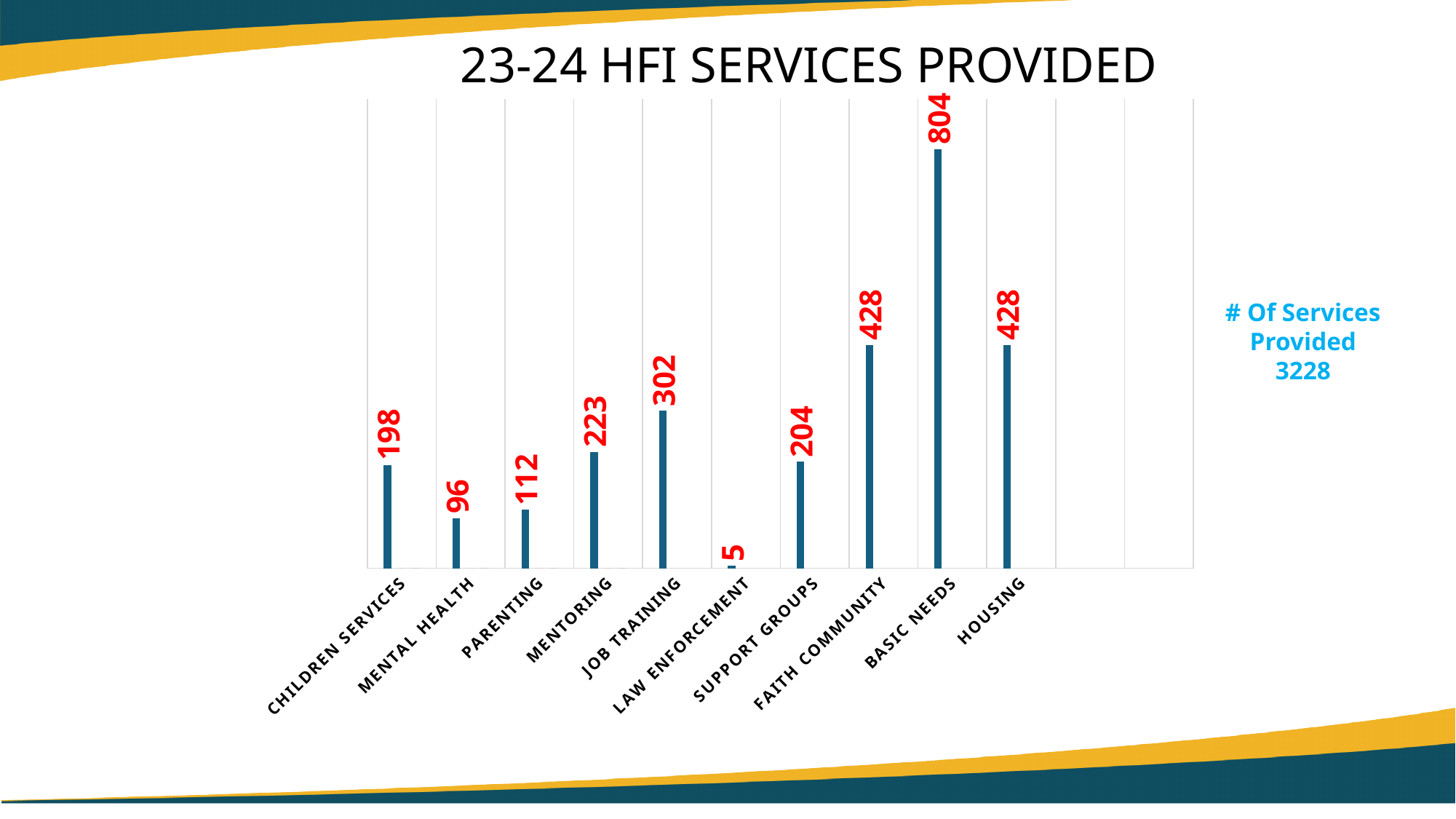
What is the title of the chart? 23-24 HFI SERVICES PROVIDED Which is larger, the value for Support Groups or the value for Parenting? Support Groups What is the difference between the values for Mentoring and Children Services? 25 What is the value for Mental Health? 96 What kind of chart is shown on the slide? Bar chart Which category has the lowest value? Law Enforcement Which category has the highest value? Basic Needs What is the value for Job Training? 302 How many categories are shown on the chart? 10 What is the value for Basic Needs? 804 What is the difference between the values for Basic Needs and Housing? 376 What is the value for Law Enforcement? 5